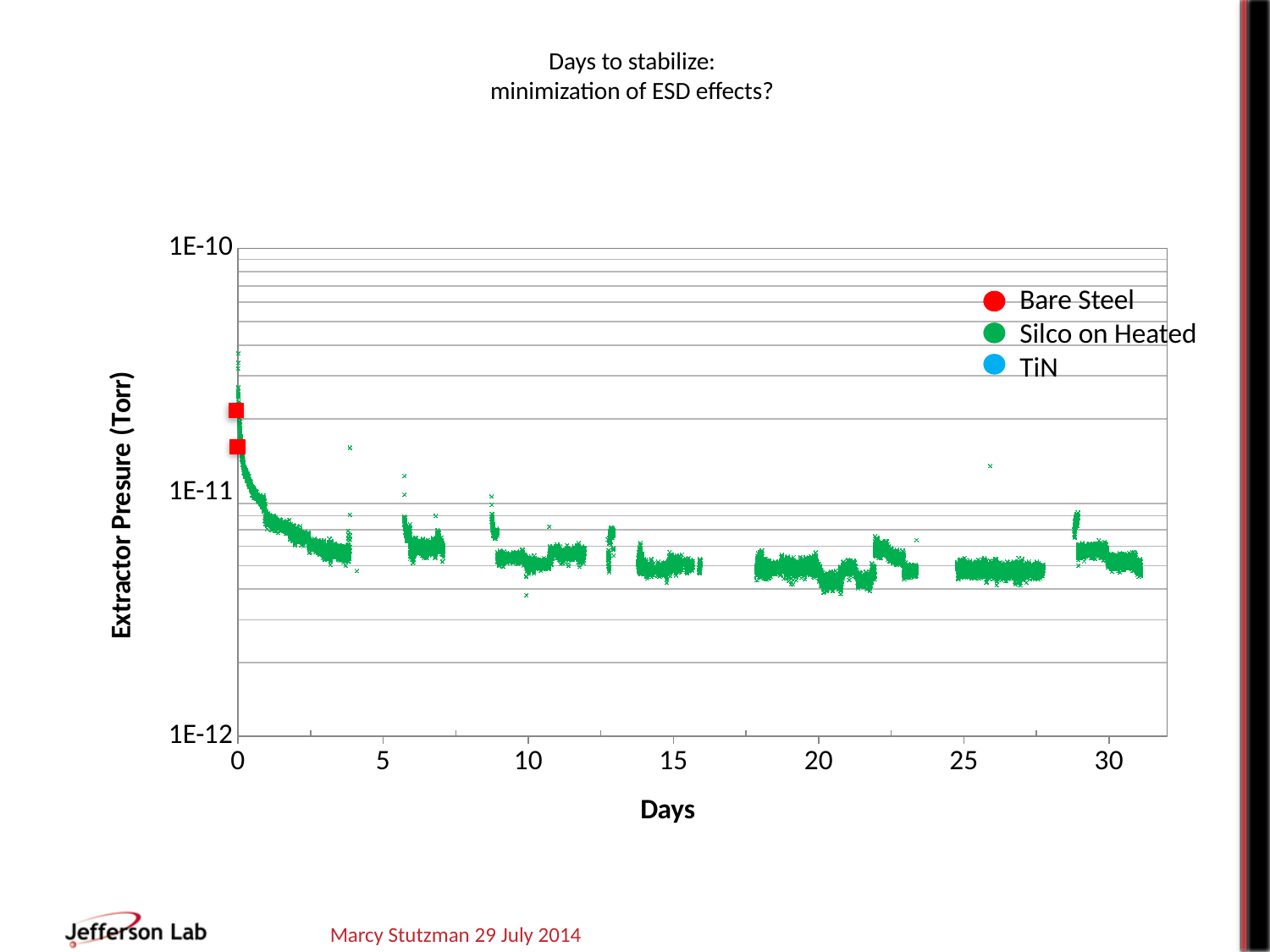
Is the Silco on Heated value at day 10 greater or less than 1E-11? less What is the label of the y axis? Extractor Presure (Torr) How many series does the legend list? 3 Is the Silco on Heated value at day 30 greater or less than 1E-11? less What kind of chart is shown on the slide? Scatter chart Do the Silco on Heated values rise or fall as the days increase from 0 to 5? fall Is the Bare Steel value at day 0 greater or less than 1E-11? greater What is the title of the chart? Days to stabilize: minimization of ESD effects? Which series is plotted in green? Silco on Heated